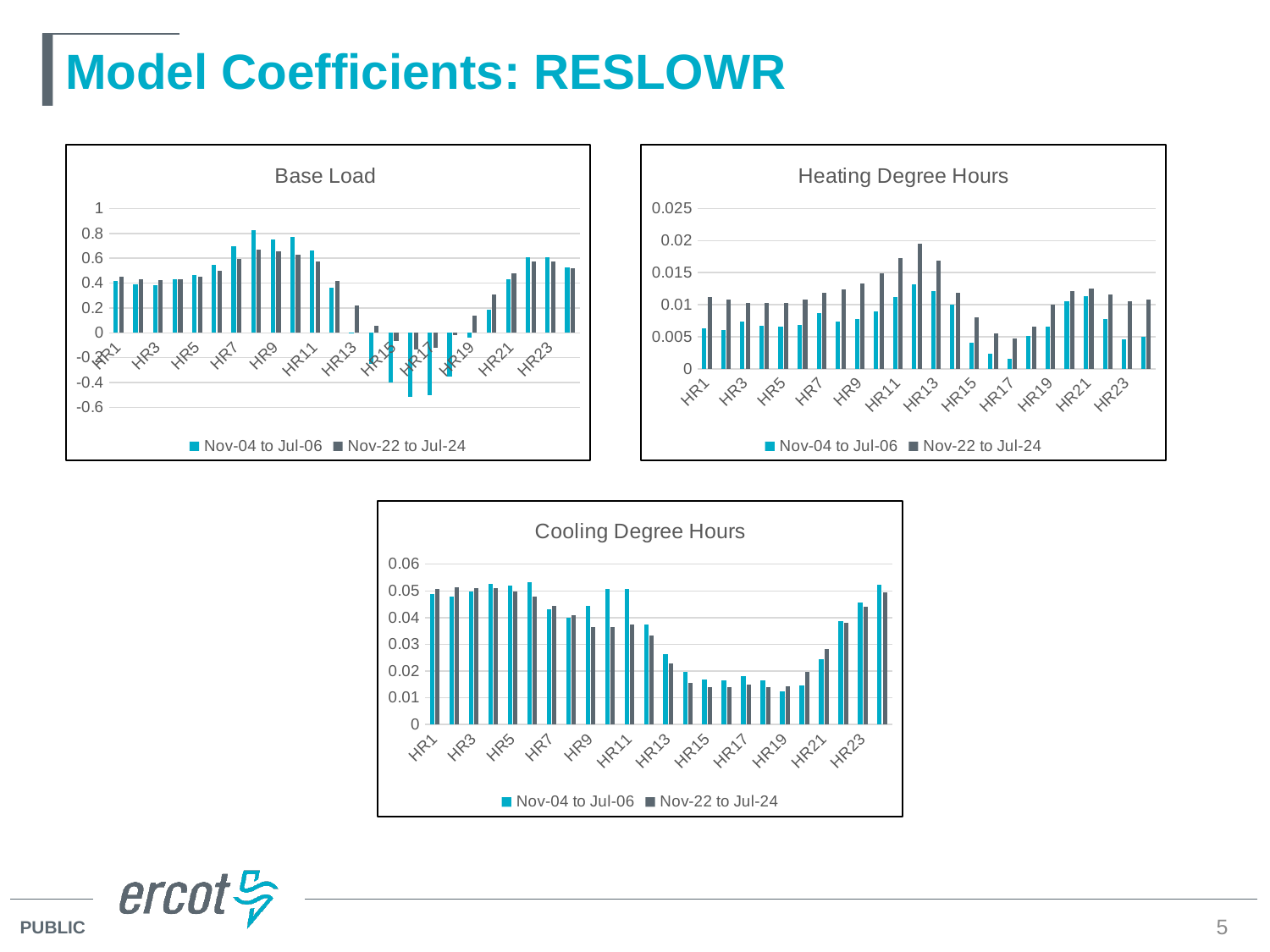
In the Heating Degree Hours chart, at which hour does the Nov-22 to Jul-24 series reach its highest value? HR12 What are the two series named in the legend of the Cooling Degree Hours chart? Nov-04 to Jul-06 and Nov-22 to Jul-24 In the Base Load chart, is the Nov-04 to Jul-06 value at HR9 greater or less than 0.6? greater In the Heating Degree Hours chart, is the Nov-22 to Jul-24 value at HR13 greater or less than 0.015? greater In the Cooling Degree Hours chart, do the Nov-04 to Jul-06 values generally rise or fall from HR7 to HR19? fall In the Heating Degree Hours chart, which series has the larger value at HR13, Nov-04 to Jul-06 or Nov-22 to Jul-24? Nov-22 to Jul-24 In the Base Load chart, is the Nov-04 to Jul-06 value at HR17 greater or less than -0.2? less How many series does the legend of the Heating Degree Hours chart list? 2 In the Base Load chart, which series has the larger value at HR9, Nov-04 to Jul-06 or Nov-22 to Jul-24? Nov-04 to Jul-06 What kind of chart is the Base Load chart? bar chart What is the title of the chart at the bottom of the slide? Cooling Degree Hours